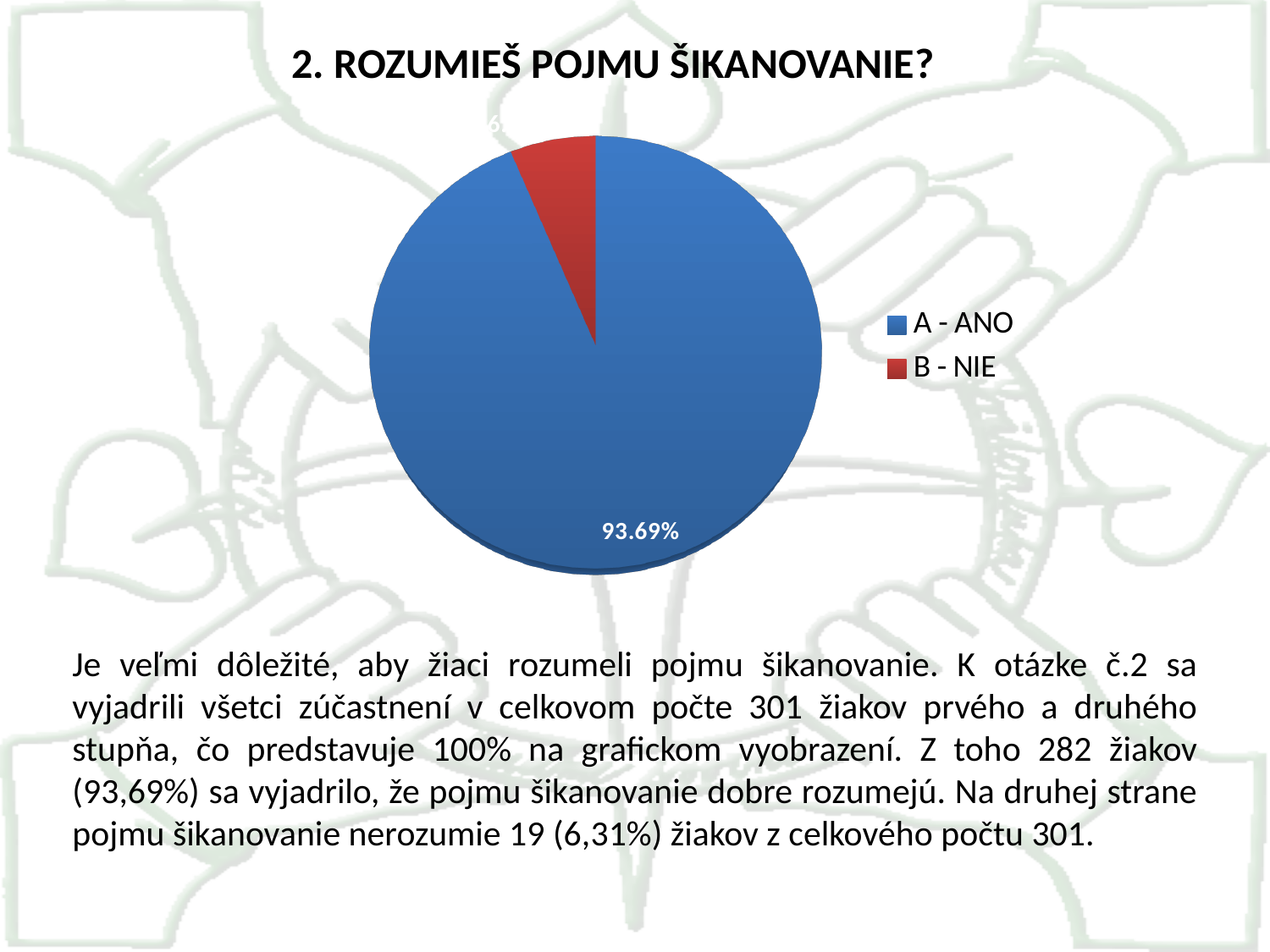
What colour is the slice for A - ANO? blue How many entries does the legend list? 2 How many slices does the pie chart have? 2 What is the data label printed on the A - ANO slice? 93.69% Which category has the largest slice of the pie? A - ANO Which slice is larger, A - ANO or B - NIE? A - ANO What is the title of the chart? 2. ROZUMIEŠ POJMU ŠIKANOVANIE? Which category has the smallest slice of the pie? B - NIE What kind of chart is shown on the slide? pie chart What share of the pie does the slice A - ANO represent? 93.69%